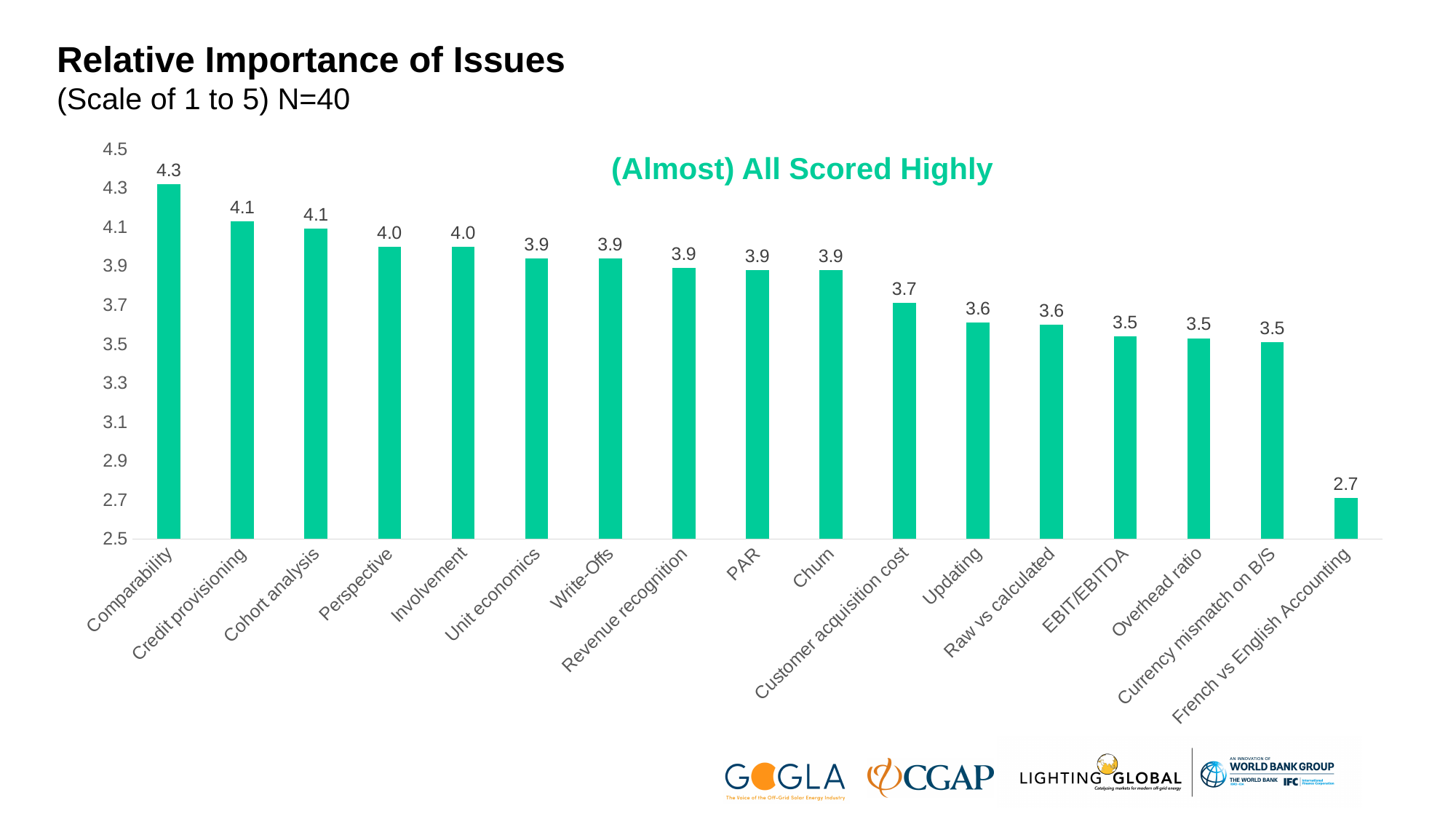
What is the value for French vs English Accounting? 2.7 Which category has the lowest value? French vs English Accounting Which category has the highest value? Comparability What is the difference between the values for Comparability and French vs English Accounting? 1.6 Is the value for Raw vs calculated greater or less than 3.5? greater How many categories are shown in the chart? 17 What is the value for Overhead ratio? 3.5 What kind of chart is shown on the slide? bar chart Do the values rise or fall from left to right along the x axis? fall What is the value for Comparability? 4.3 What is the value for Customer acquisition cost? 3.7 Which is larger, the value for Perspective or the value for Updating? Perspective